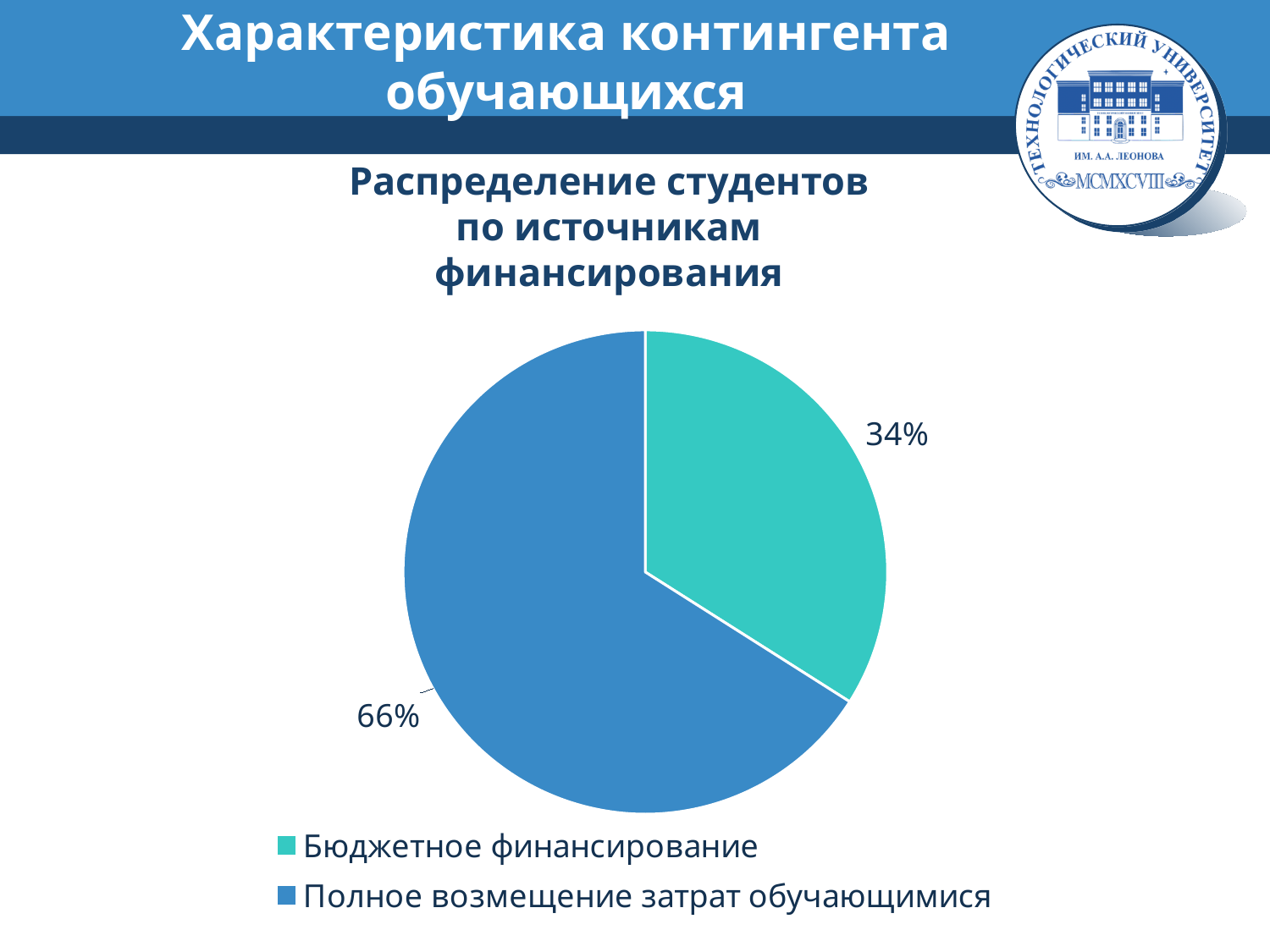
What kind of chart is shown on the slide? pie chart Which is larger: the slice for Бюджетное финансирование or the slice for Полное возмещение затрат обучающимися? Полное возмещение затрат обучающимися How many categories does the pie chart show? 2 What is the difference in percentage points between the two slices? 32 What share of the pie is labelled for Полное возмещение затрат обучающимися? 66% What is the title of the chart? Распределение студентов по источникам финансирования What share of the pie is labelled for Бюджетное финансирование? 34% Which category has the smallest slice of the pie? Бюджетное финансирование What is the total of the two percentages shown on the pie? 100% What colour is the slice for Бюджетное финансирование? teal (green) How many entries does the legend list? 2 Which category has the largest slice of the pie? Полное возмещение затрат обучающимися